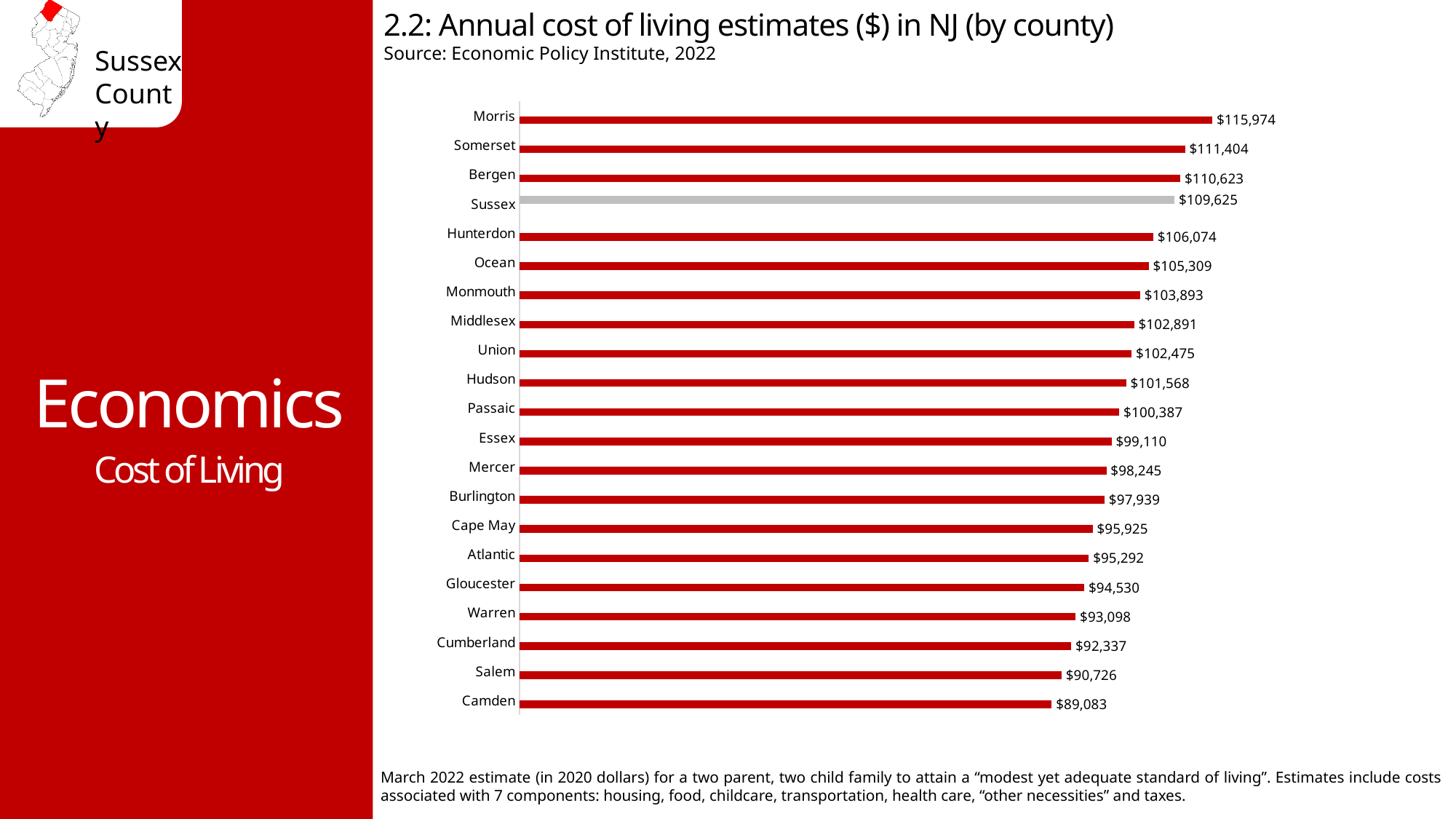
Which county has a higher cost of living estimate, Salem or Cumberland? Cumberland What is the annual cost of living estimate for Cape May County? $95,925 Which county's bar is shown in gray rather than red? Sussex What is the annual cost of living estimate for Sussex County? $109,625 How many counties are shown in the chart? 21 Which county has the lowest annual cost of living estimate? Camden What type of chart is used to show the annual cost of living estimates? Bar chart Which county has a higher cost of living estimate, Ocean or Monmouth? Ocean What is the difference between the cost of living estimates for Morris and Camden counties? $26,891 What is the difference between the cost of living estimates for Sussex and Warren counties? $16,527 What is the annual cost of living estimate for Hunterdon County? $106,074 Which county has the highest annual cost of living estimate? Morris